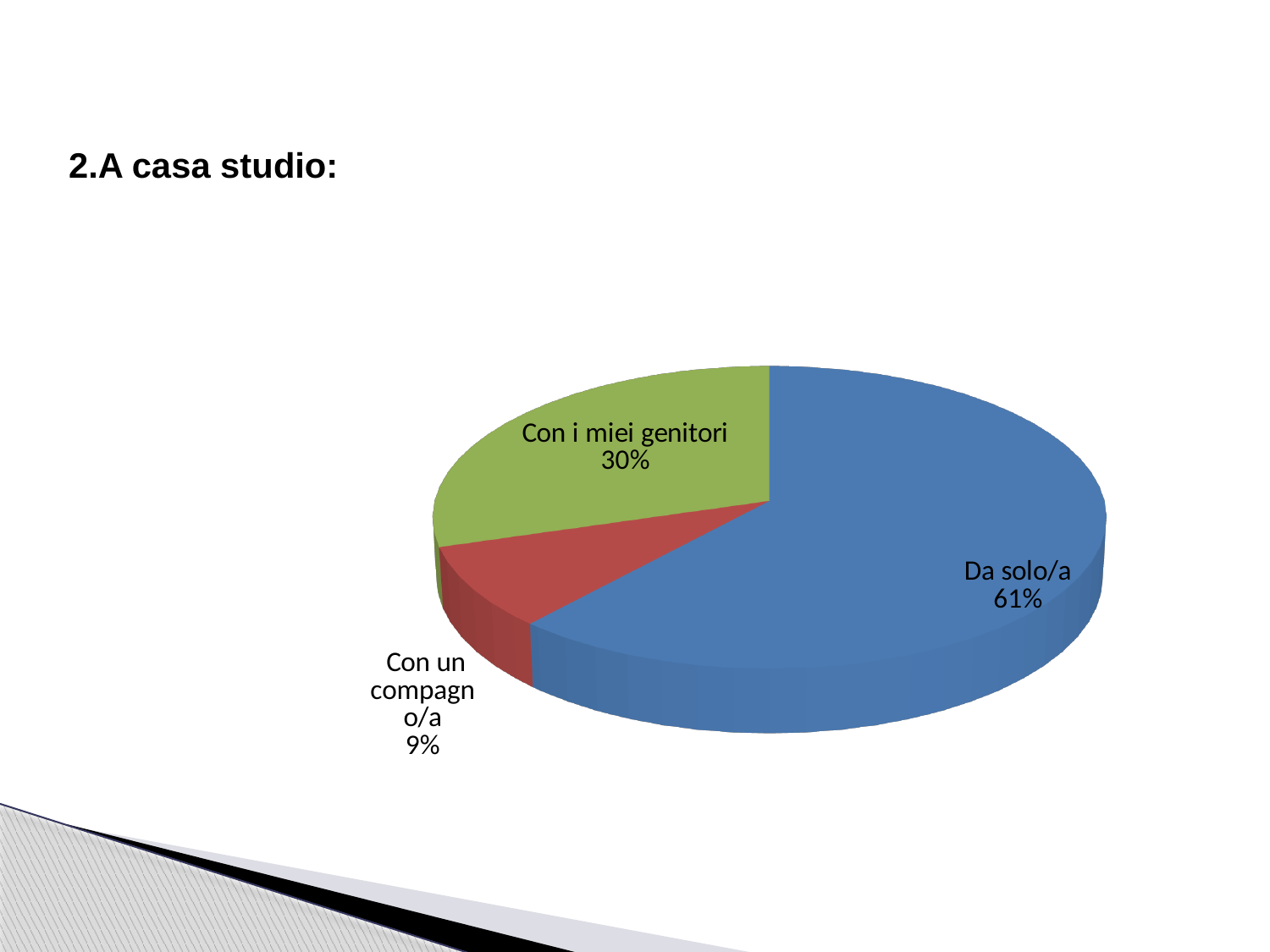
Which category has the smallest slice of the pie? Con un compagno/a What share of the pie does "Da solo/a" represent? 61% Which is larger, the slice for "Con i miei genitori" or the slice for "Con un compagno/a"? Con i miei genitori Which category has the largest slice of the pie? Da solo/a What is the heading text above the chart on the slide? 2.A casa studio: What is the difference in percentage points between "Da solo/a" and "Con i miei genitori"? 31 What share of the pie does "Con i miei genitori" represent? 30% What colour is the slice for "Da solo/a"? blue What kind of chart is shown on the slide? pie chart What share of the pie does "Con un compagno/a" represent? 9% How many slices does the pie chart have? 3 What is the difference in percentage points between "Con i miei genitori" and "Con un compagno/a"? 21